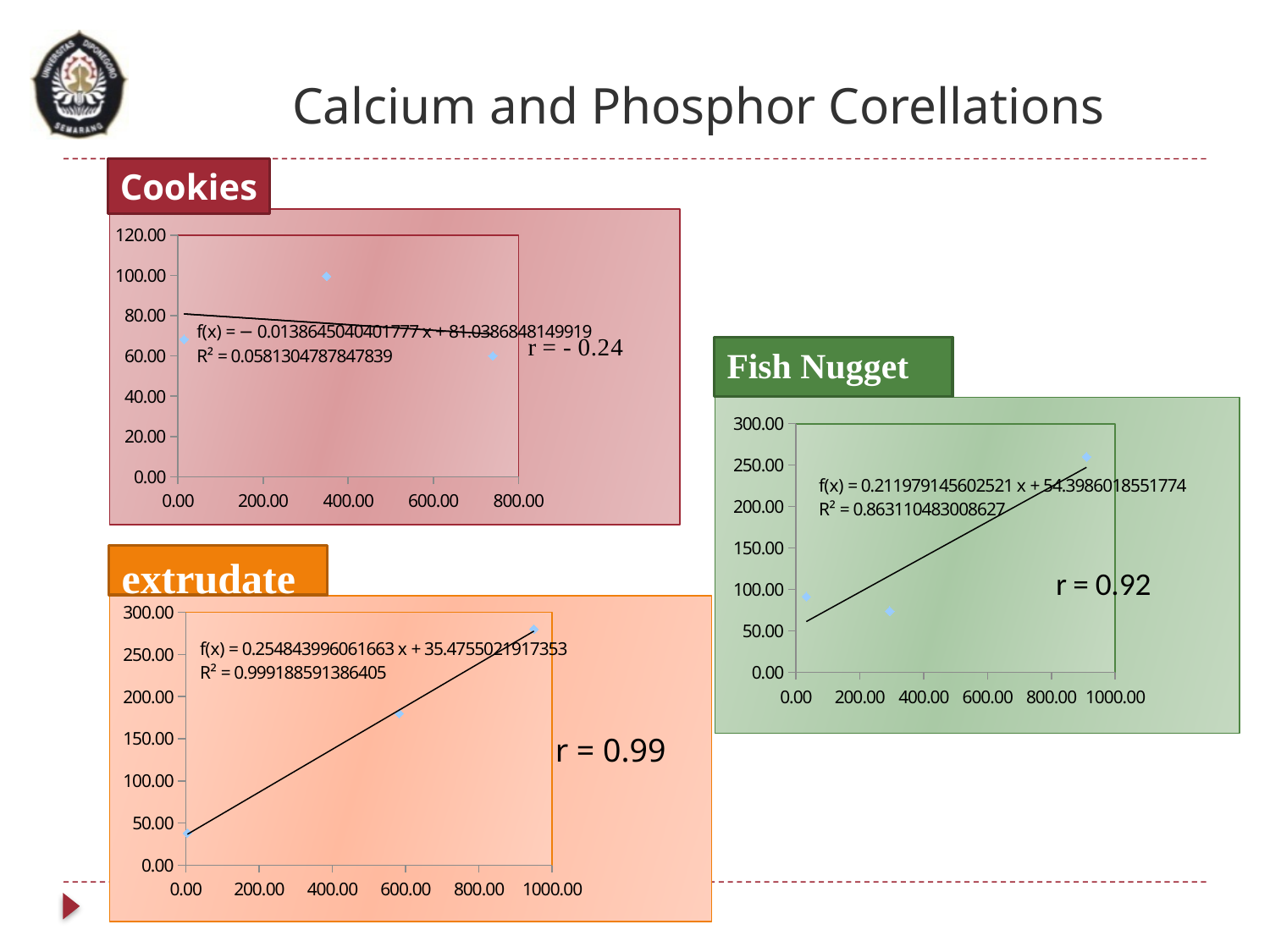
Which of the three charts shows the highest R² value? extrudate On the extrudate chart, is the value of the lowest point greater or less than 50.00? less What correlation coefficient r is shown next to the Cookies chart? r = - 0.24 On the Fish Nugget chart, is the value of the highest point greater or less than 200.00? greater What kind of chart is the Cookies chart? scatter chart How many data points are plotted on the Fish Nugget chart? 3 What R² value is printed on the Fish Nugget chart? 0.863110483008627 What R² value is printed on the extrudate chart? 0.999188591386405 How many data points are plotted on the extrudate chart? 3 On the Cookies chart, does the fitted trend line slope upward or downward? downward On the extrudate chart, do the plotted values rise or fall as the x value increases? rise What R² value is printed on the Cookies chart? 0.0581304787847839